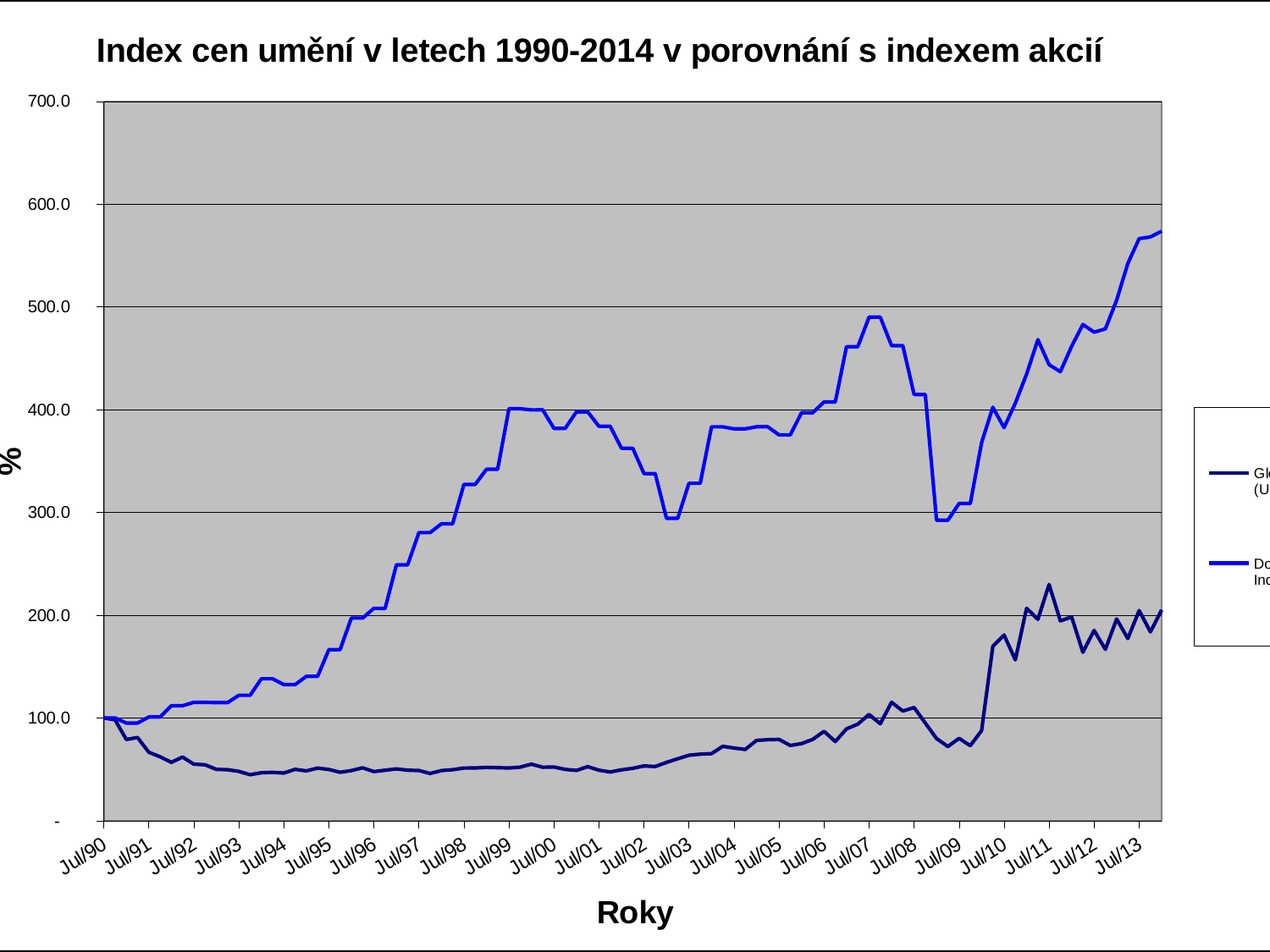
Is the value of the dark navy line at Jul/95 greater or less than 100? less What is the title of the chart? Index cen umění v letech 1990-2014 v porovnání s indexem akcií Is the value of the dark navy line at Jul/13 greater or less than 300? less Is the value of the dark navy line at Jul/11 greater or less than 100? greater How many series does the legend list? 2 What is the label of the x axis? Roky Does the bright blue line overall rise or fall from Jul/90 to Jul/13? rise At Jul/07, which line has the higher value, the bright blue line or the dark navy line? the bright blue line What kind of chart is shown on the slide? line chart